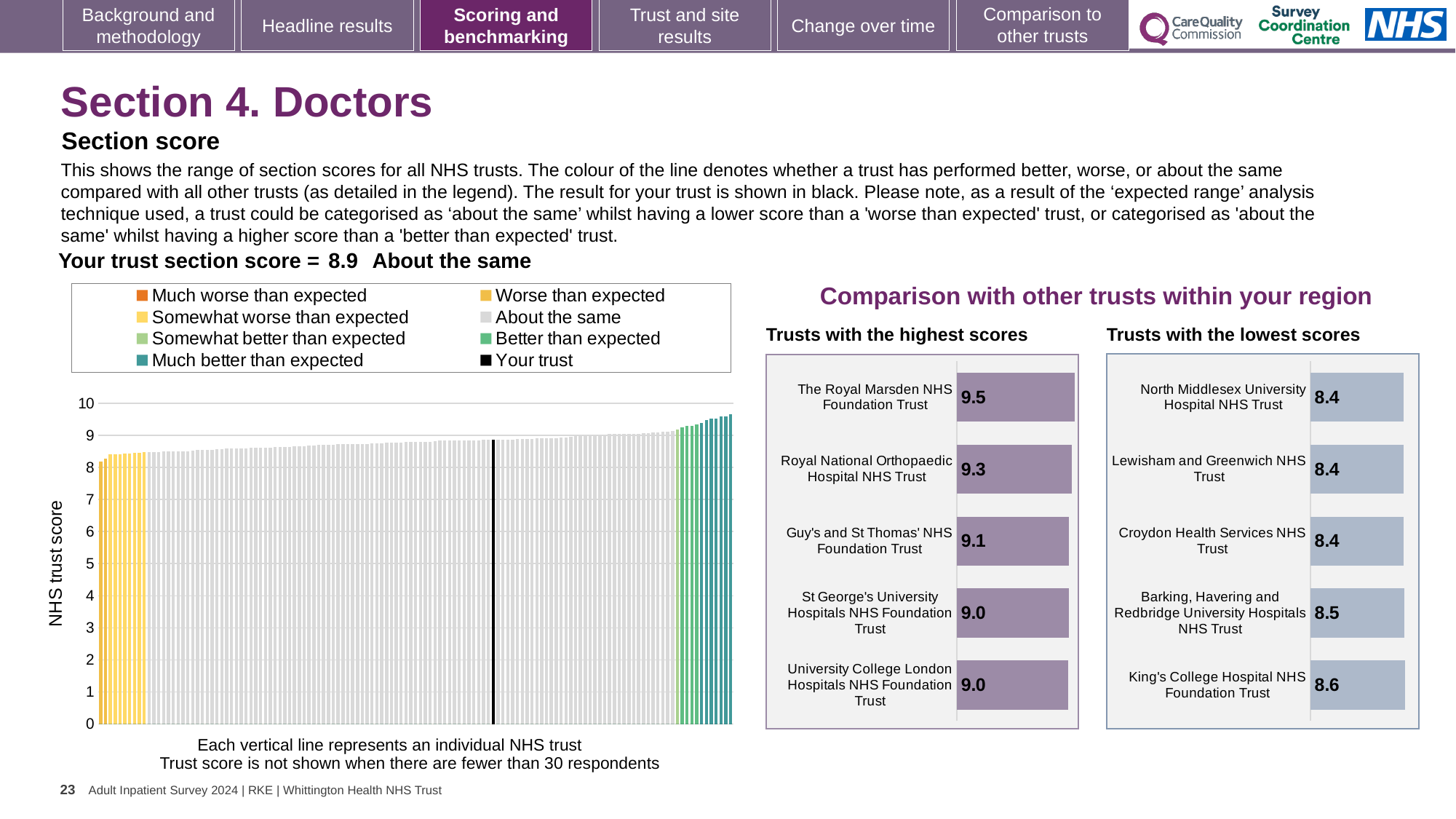
In the 'Trusts with the highest scores' chart, what is the score for Guy's and St Thomas' NHS Foundation Trust? 9.1 In the 'Trusts with the lowest scores' chart, which has the larger score: King's College Hospital NHS Foundation Trust or Croydon Health Services NHS Trust? King's College Hospital NHS Foundation Trust In the large chart on the left showing NHS trust scores, what kind of chart is it? Bar chart In the 'Trusts with the highest scores' chart, what is the difference between the scores of The Royal Marsden NHS Foundation Trust and Royal National Orthopaedic Hospital NHS Trust? 0.2 In the 'Trusts with the lowest scores' chart, which trust has the highest score? King's College Hospital NHS Foundation Trust How many trusts are listed in the 'Trusts with the highest scores' chart? 5 In the 'Trusts with the highest scores' chart, what is the score for The Royal Marsden NHS Foundation Trust? 9.5 In the 'Trusts with the lowest scores' chart, what is the score for Barking, Havering and Redbridge University Hospitals NHS Trust? 8.5 In the large chart on the left showing NHS trust scores, how many entries does the legend list? 8 In the 'Trusts with the lowest scores' chart, what is the score for King's College Hospital NHS Foundation Trust? 8.6 In the 'Trusts with the highest scores' chart, which trust has the highest score? The Royal Marsden NHS Foundation Trust In the 'Trusts with the lowest scores' chart, what is the difference between the scores of King's College Hospital NHS Foundation Trust and North Middlesex University Hospital NHS Trust? 0.2